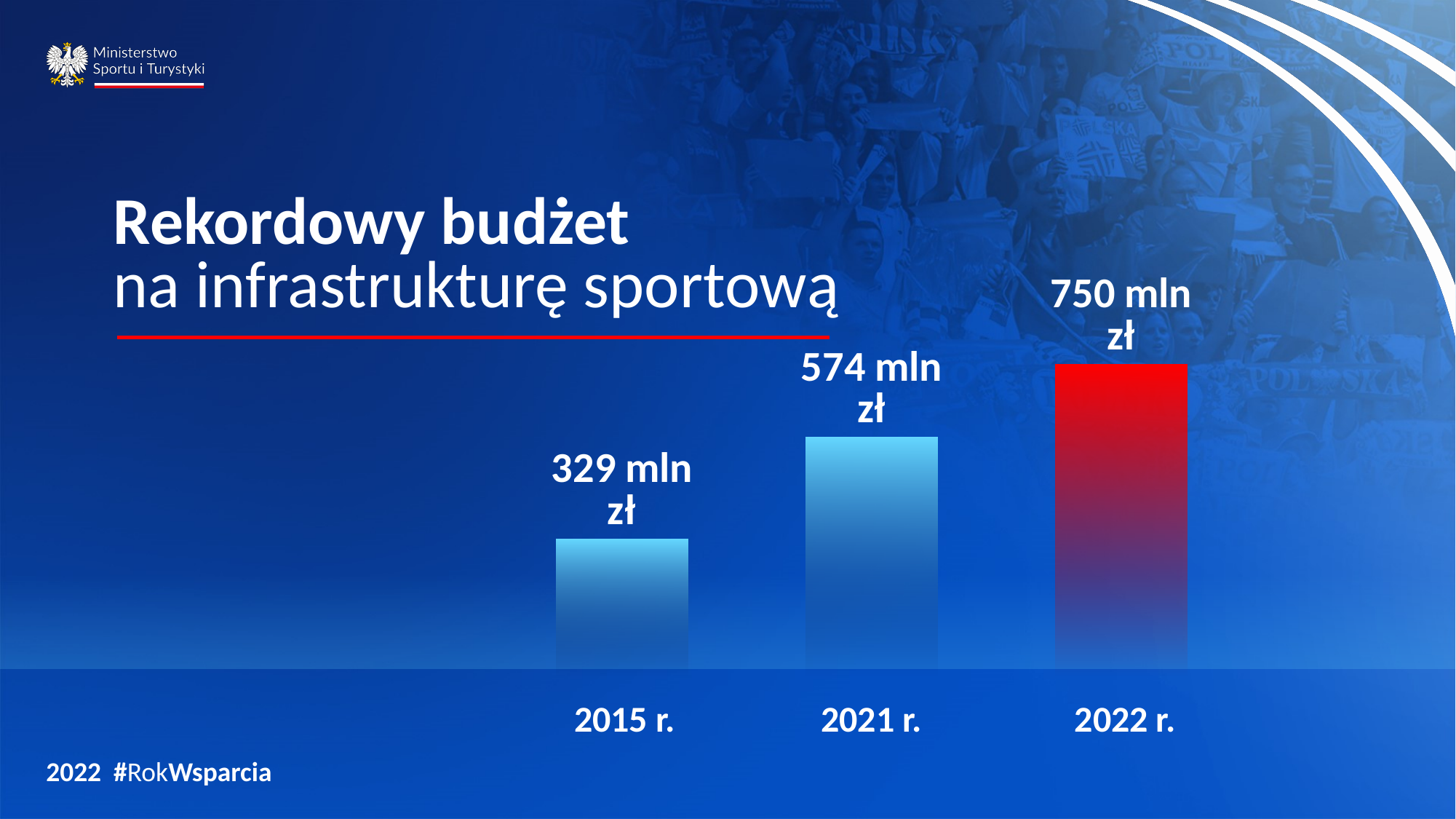
What is the difference between the values for 2021 r. and 2015 r.? 245 mln zł Do the values rise or fall from 2015 r. to 2022 r.? rise How many years are shown in the chart? 3 Which year has the lowest value? 2015 r. Which is larger, the value for 2015 r. or the value for 2021 r.? 2021 r. What is the value for 2022 r.? 750 mln zł What is the value for 2015 r.? 329 mln zł What is the value for 2021 r.? 574 mln zł What colour is the bar for 2022 r.? red What is the difference between the values for 2022 r. and 2021 r.? 176 mln zł Which year has the highest value? 2022 r. What kind of chart is shown on the slide? bar chart